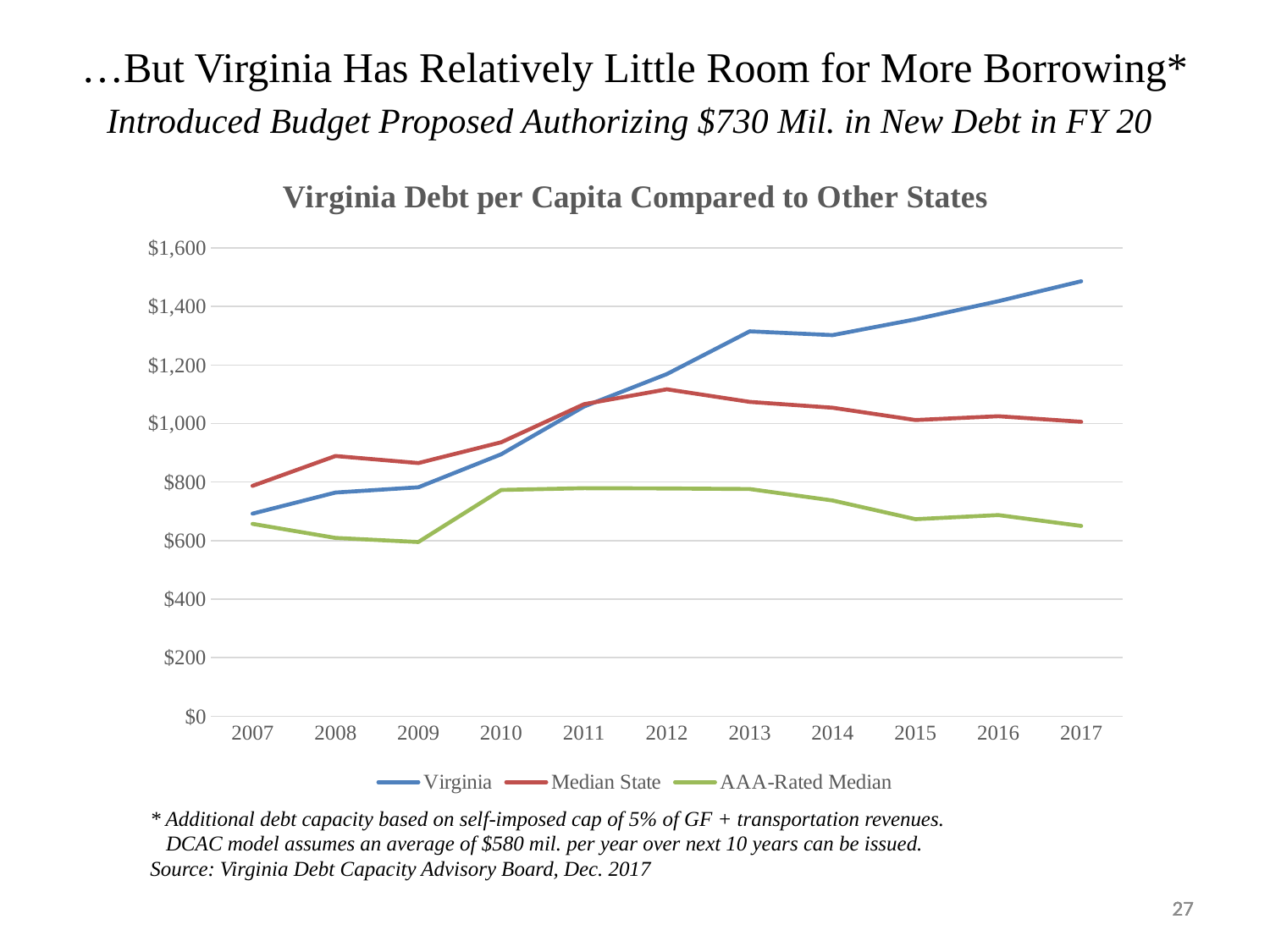
Is the value for Virginia in 2007 greater or less than $800? less Which series has the lowest value in 2017? AAA-Rated Median What kind of chart is shown on the slide? line chart Is the value for AAA-Rated Median in 2013 greater or less than $800? less How many years are shown on the x axis? 11 How many series does the legend list? 3 In which year is the Virginia series at its highest? 2017 Is the value for Median State in 2012 greater or less than $1,000? greater In 2007, which is larger: Virginia or Median State? Median State What is the title of the chart? Virginia Debt per Capita Compared to Other States In 2017, which is larger: Virginia or Median State? Virginia